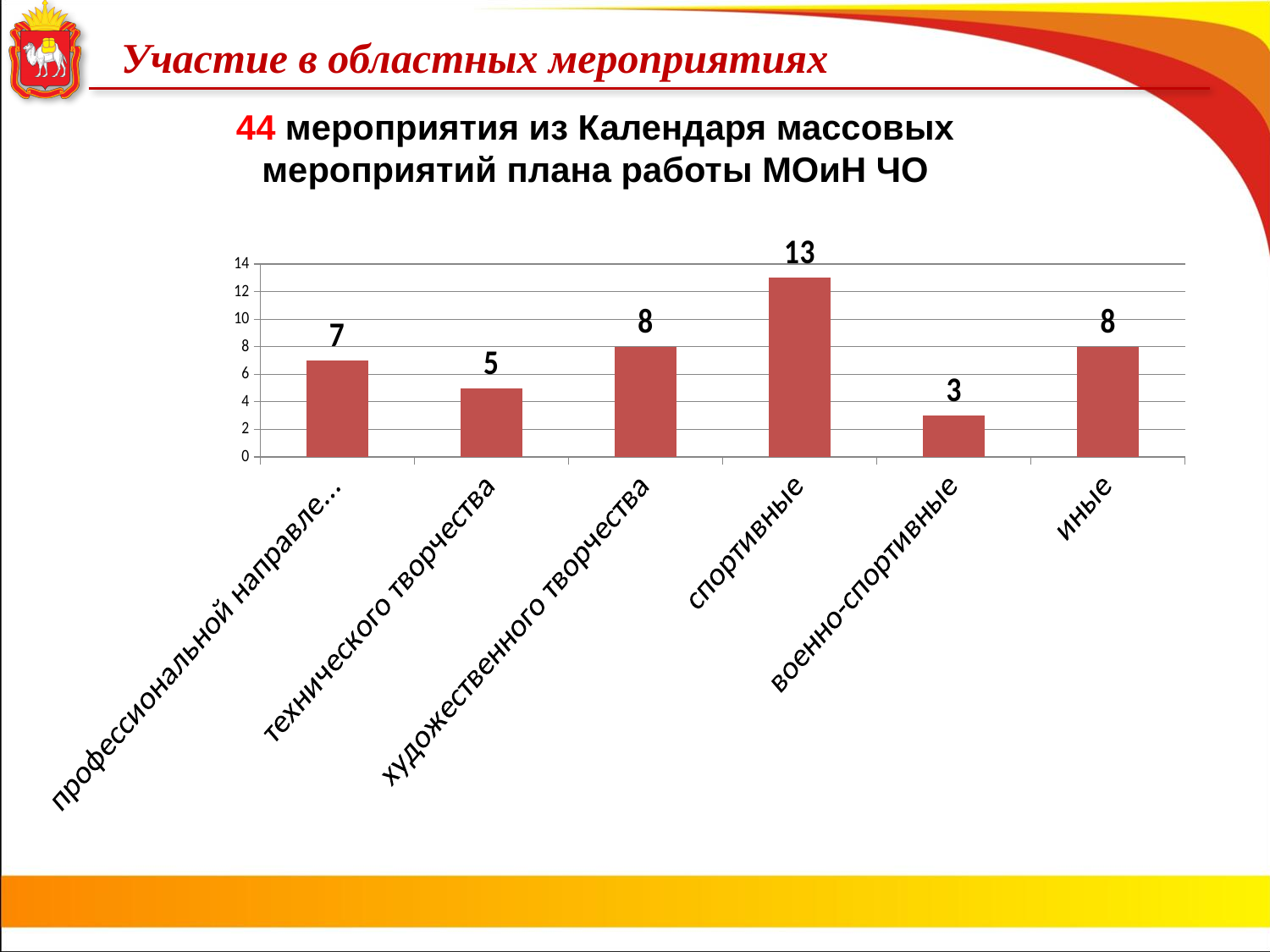
Which category has the highest value? спортивные What is the difference between the values for спортивные and военно-спортивные? 10 What is the value for технического творчества? 5 What total number of events is stated in the text above the chart? 44 What is the value for военно-спортивные? 3 What is the value of the first (leftmost) bar in the chart? 7 What is the value for иные? 8 What is the value for спортивные? 13 Which category has the lowest value? военно-спортивные How many categories are plotted in the bar chart? 6 What kind of chart is shown on the slide? bar chart Which is larger, the value for художественного творчества or the value for технического творчества? художественного творчества